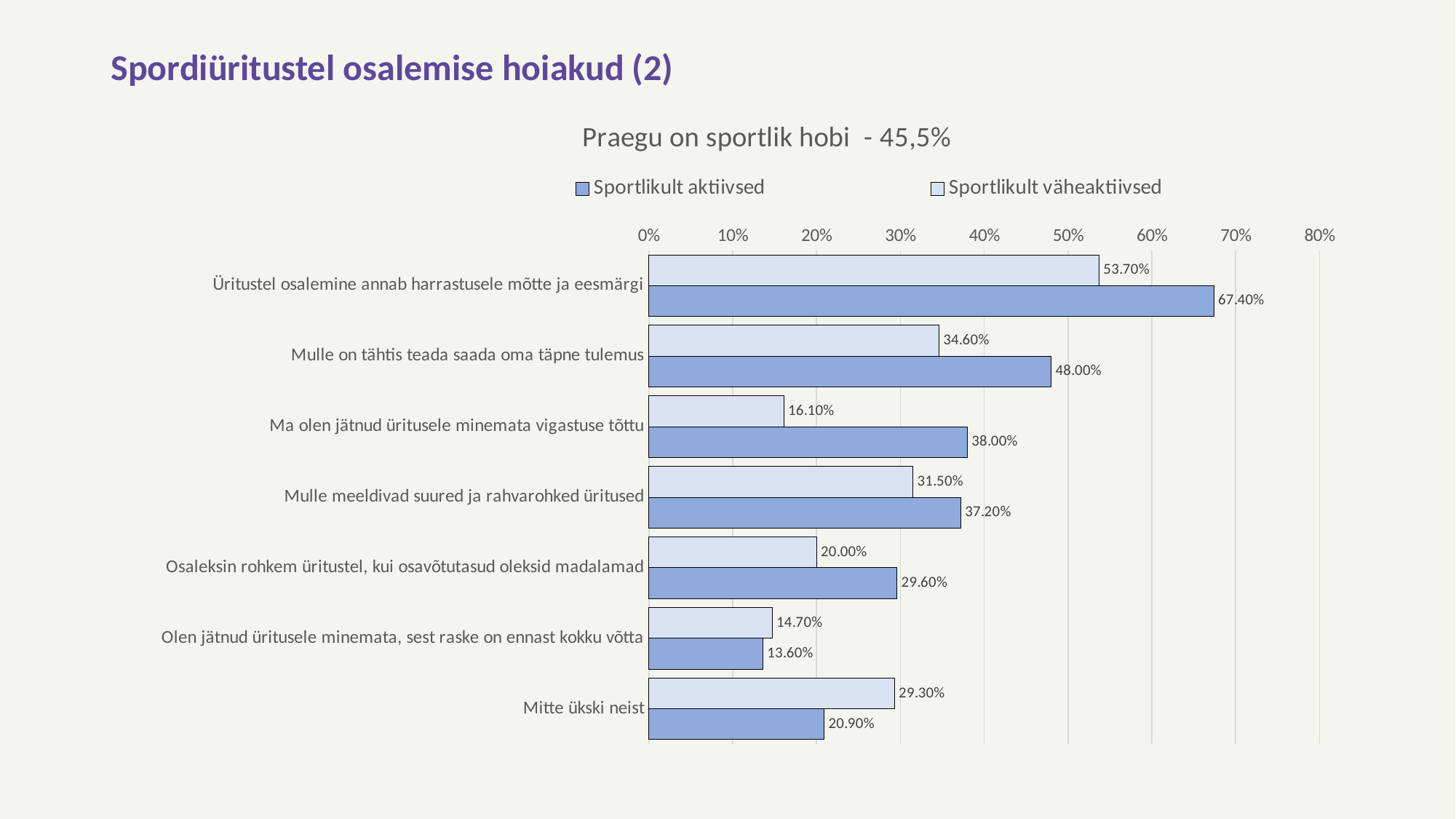
How many series does the legend list? 2 Is the "Sportlikult aktiivsed" value for "Mulle on tähtis teada saada oma täpne tulemus" greater or less than 40%? greater What is the value for "Sportlikult aktiivsed" in the category "Üritustel osalemine annab harrastusele mõtte ja eesmärgi"? 67.40% What is the difference between the "Sportlikult aktiivsed" and "Sportlikult väheaktiivsed" values for "Ma olen jätnud üritusele minemata vigastuse tõttu"? 21.90% What is the value for "Sportlikult väheaktiivsed" in the category "Mulle on tähtis teada saada oma täpne tulemus"? 34.60% How many categories are shown on the chart? 7 What kind of chart is shown on the slide? Bar chart What is the title of the chart? Praegu on sportlik hobi - 45,5% What is the value for "Sportlikult aktiivsed" in the category "Mitte ükski neist"? 20.90% Which category has the highest value for "Sportlikult aktiivsed"? Üritustel osalemine annab harrastusele mõtte ja eesmärgi For "Mitte ükski neist", which series has the larger value: "Sportlikult aktiivsed" or "Sportlikult väheaktiivsed"? Sportlikult väheaktiivsed Which category has the lowest value for "Sportlikult väheaktiivsed"? Olen jätnud üritusele minemata, sest raske on ennast kokku võtta